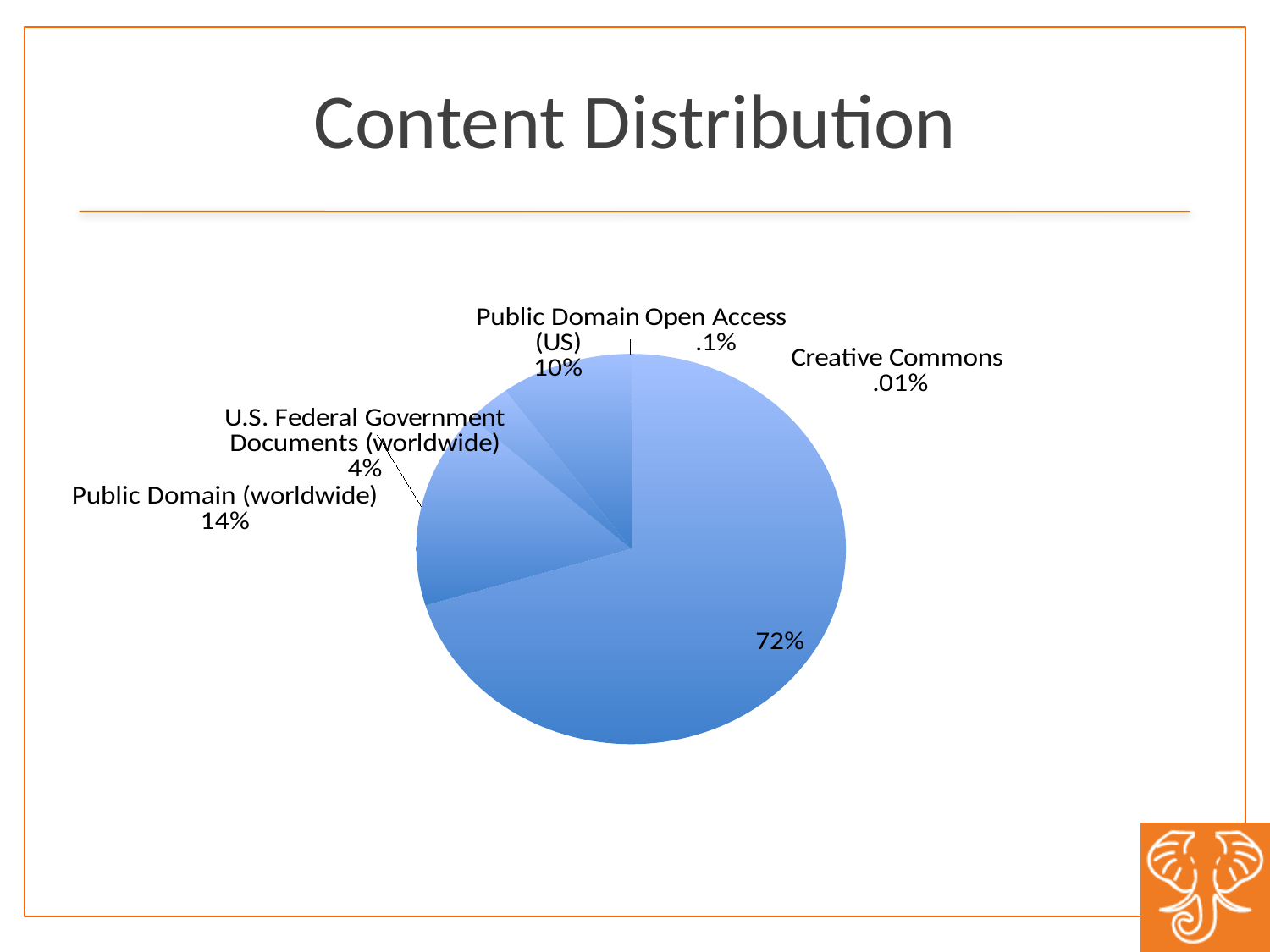
What share does the Public Domain (US) slice have? 10% What percentage is shown for Open Access? .1% How many percentage points larger is Public Domain (worldwide) than U.S. Federal Government Documents (worldwide)? 10% How many slices are labelled with a percentage on the pie chart? 6 What percentage is shown for U.S. Federal Government Documents (worldwide)? 4% What percentage is shown for Creative Commons? .01% Which named category has the smallest share of the pie? Creative Commons Which has the larger share: Public Domain (US) or U.S. Federal Government Documents (worldwide)? Public Domain (US) What percentage of the pie is labelled Public Domain (worldwide)? 14% What is the largest percentage labelled on the pie chart? 72% What is the title of the slide containing the chart? Content Distribution What kind of chart is shown on the slide? Pie chart